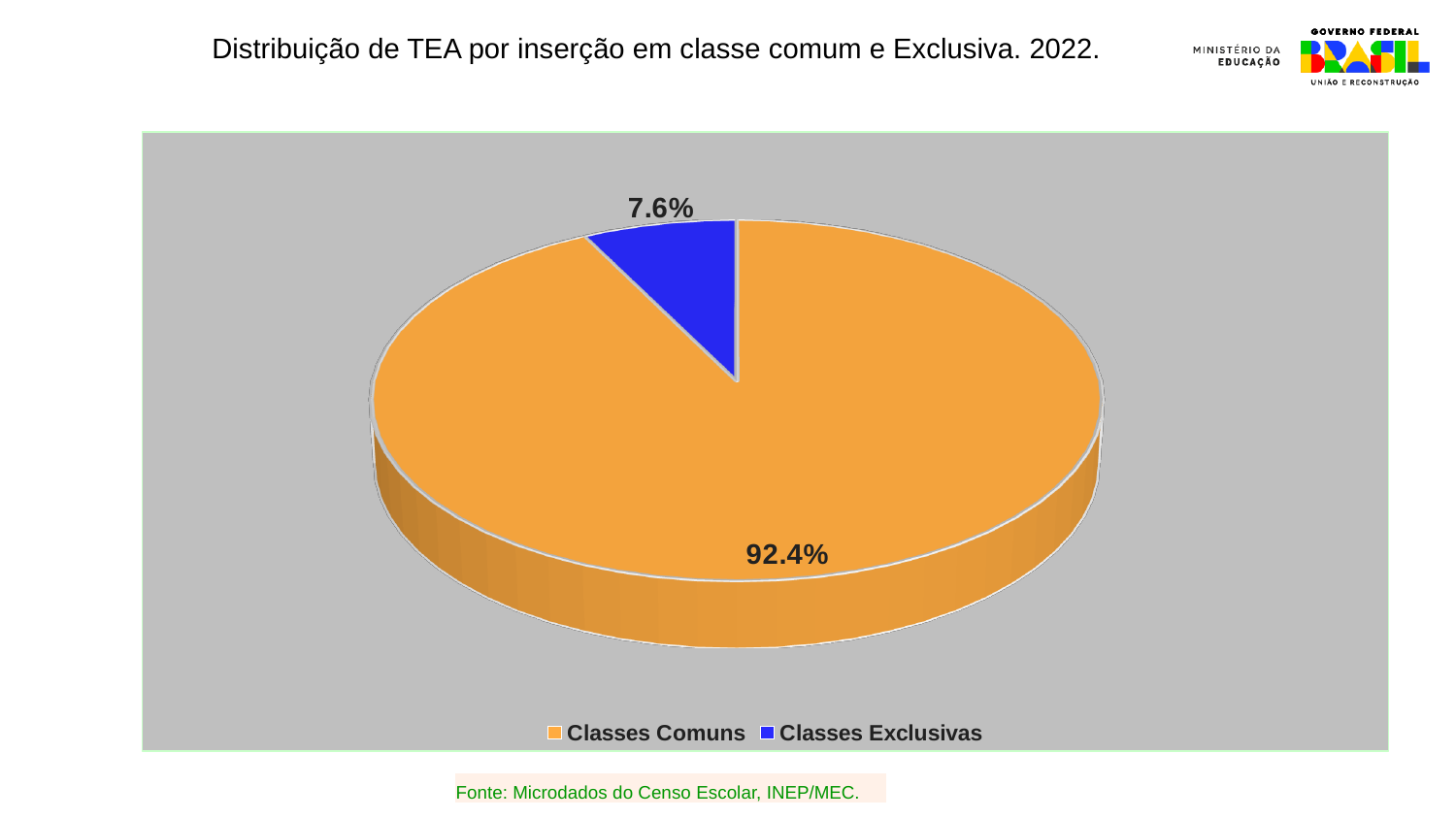
Which is larger, the share for Classes Comuns or for Classes Exclusivas? Classes Comuns Which category has the smallest slice of the pie? Classes Exclusivas What share of the pie is Classes Comuns? 92.4% How many categories does the pie chart show? 2 What colour is the Classes Exclusivas slice? Blue What kind of chart is shown on the slide? Pie chart What is the difference in percentage points between Classes Comuns and Classes Exclusivas? 84.8 How many entries does the legend list? 2 What share of the pie is Classes Exclusivas? 7.6% Which category has the largest slice of the pie? Classes Comuns What is the title of the chart on the slide? Distribuição de TEA por inserção em classe comum e Exclusiva. 2022.